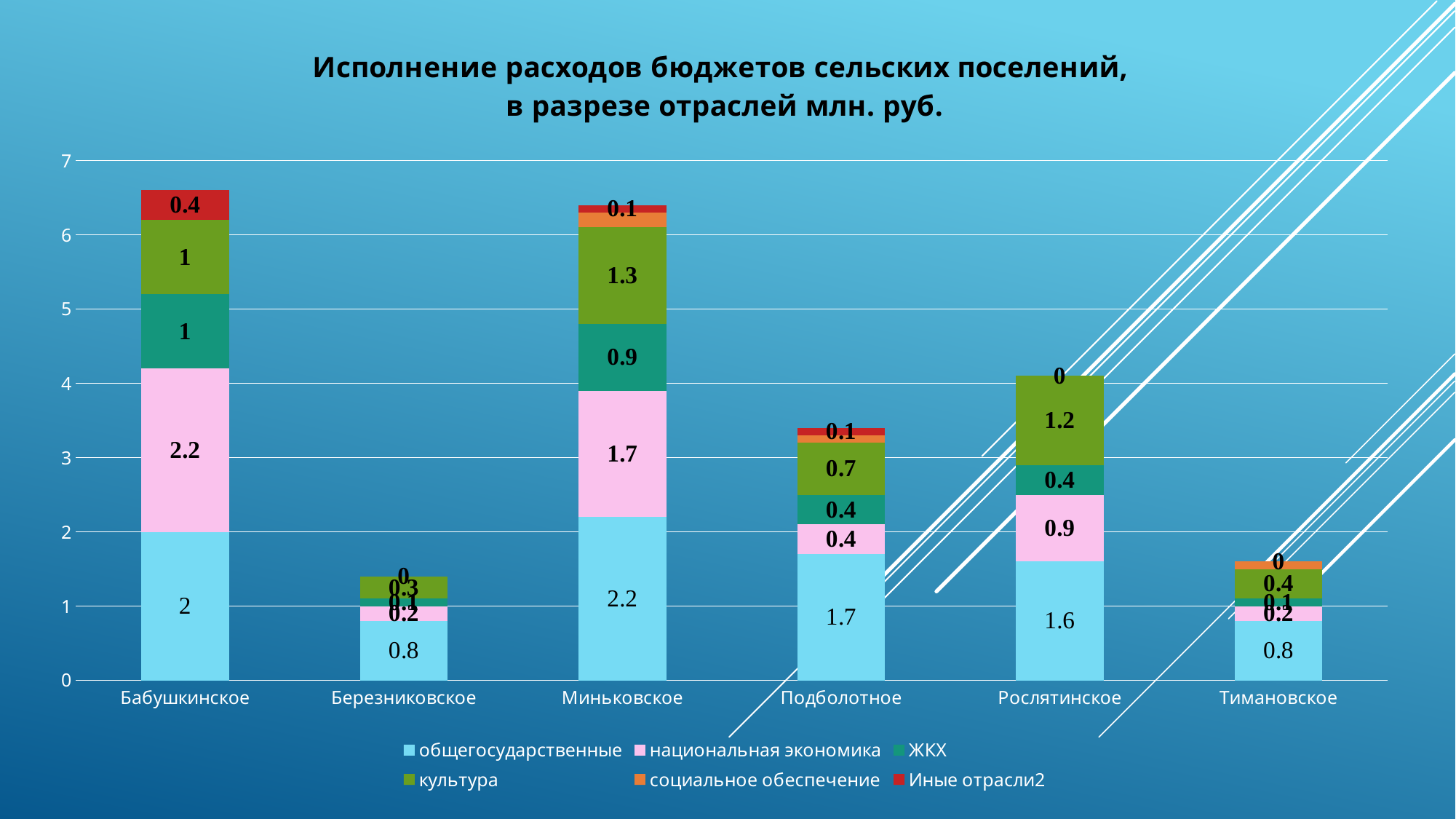
Which is larger, the национальная экономика value for Бабушкинское or for Миньковское? Бабушкинское What is the value of общегосударственные for Миньковское? 2.2 What is the value of национальная экономика for Бабушкинское? 2.2 How many series does the legend list? 6 What is the value of культура for Рослятинское? 1.2 Is the total height of the Подболотное bar greater or less than 4? less What is the value of ЖКХ for Подболотное? 0.4 Is the total height of the Бабушкинское bar greater or less than 6? greater What kind of chart is shown on the slide? Stacked bar chart What is the difference between the культура values for Миньковское and Подболотное? 0.6 Which settlement has the highest value for общегосударственные? Миньковское How many settlements (categories) are shown on the x axis? 6